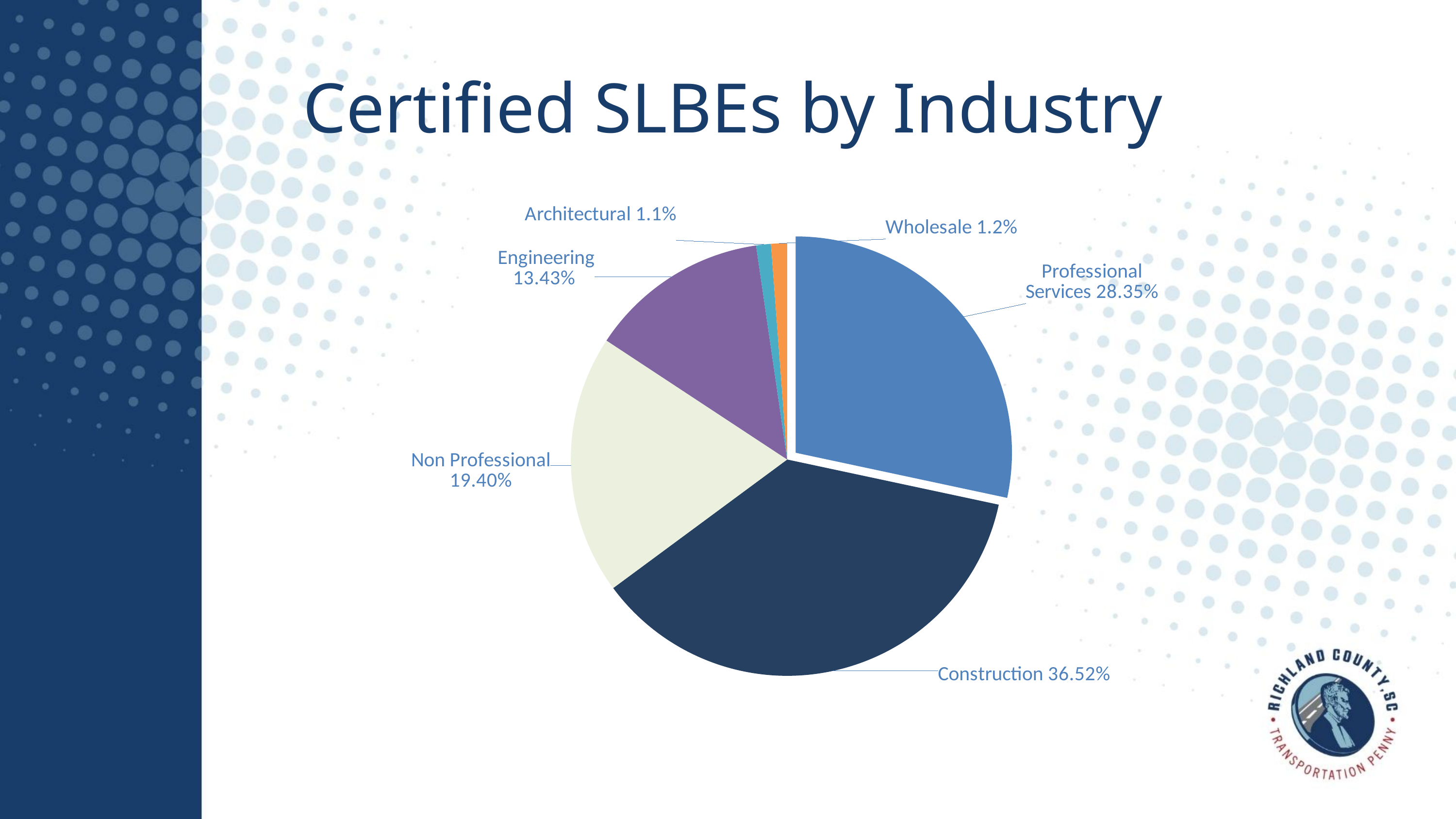
What share of certified SLBEs is in Engineering? 13.43% What share of certified SLBEs is in Professional Services? 28.35% Which industry has the largest share of certified SLBEs? Construction What is the difference in percentage points between Construction and Professional Services? 8.17 What share of certified SLBEs is in Wholesale? 1.2% What share of certified SLBEs is in Construction? 36.52% How many industries are shown in the pie chart? 6 What share of certified SLBEs is in Non Professional? 19.40% Which industry has the smallest share of certified SLBEs? Architectural Which has a larger share, Non Professional or Engineering? Non Professional What is the title of the chart? Certified SLBEs by Industry What kind of chart is shown on the slide? Pie chart